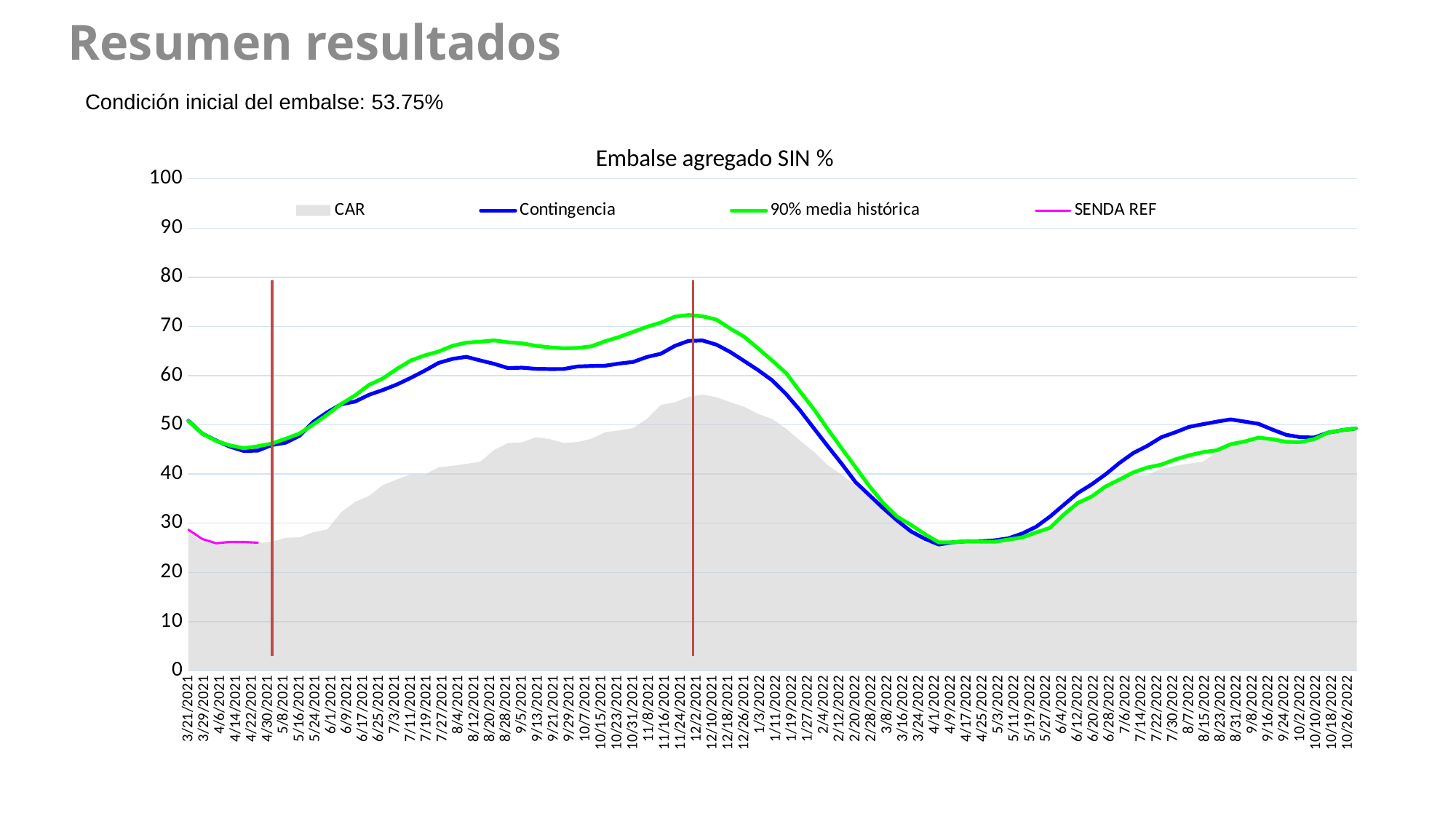
Which series reaches the highest peak value in the chart? 90% media histórica What kind of chart is shown on the slide? Line chart with a shaded area series At 8/23/2022, which is higher: Contingencia or 90% media histórica? Contingencia Is the value of CAR at 4/1/2022 greater or less than 30? less Does the Contingencia series rise or fall between 4/1/2022 and 8/23/2022? rise What is the title of the chart? Embalse agregado SIN % Which series in the chart is drawn as a shaded grey area? CAR Is the value of Contingencia at 4/14/2021 greater or less than 50? less Is the value of Contingencia at 12/2/2021 greater or less than 60? greater How many series does the legend of the chart list? 4 At 12/2/2021, which is higher: Contingencia or 90% media histórica? 90% media histórica